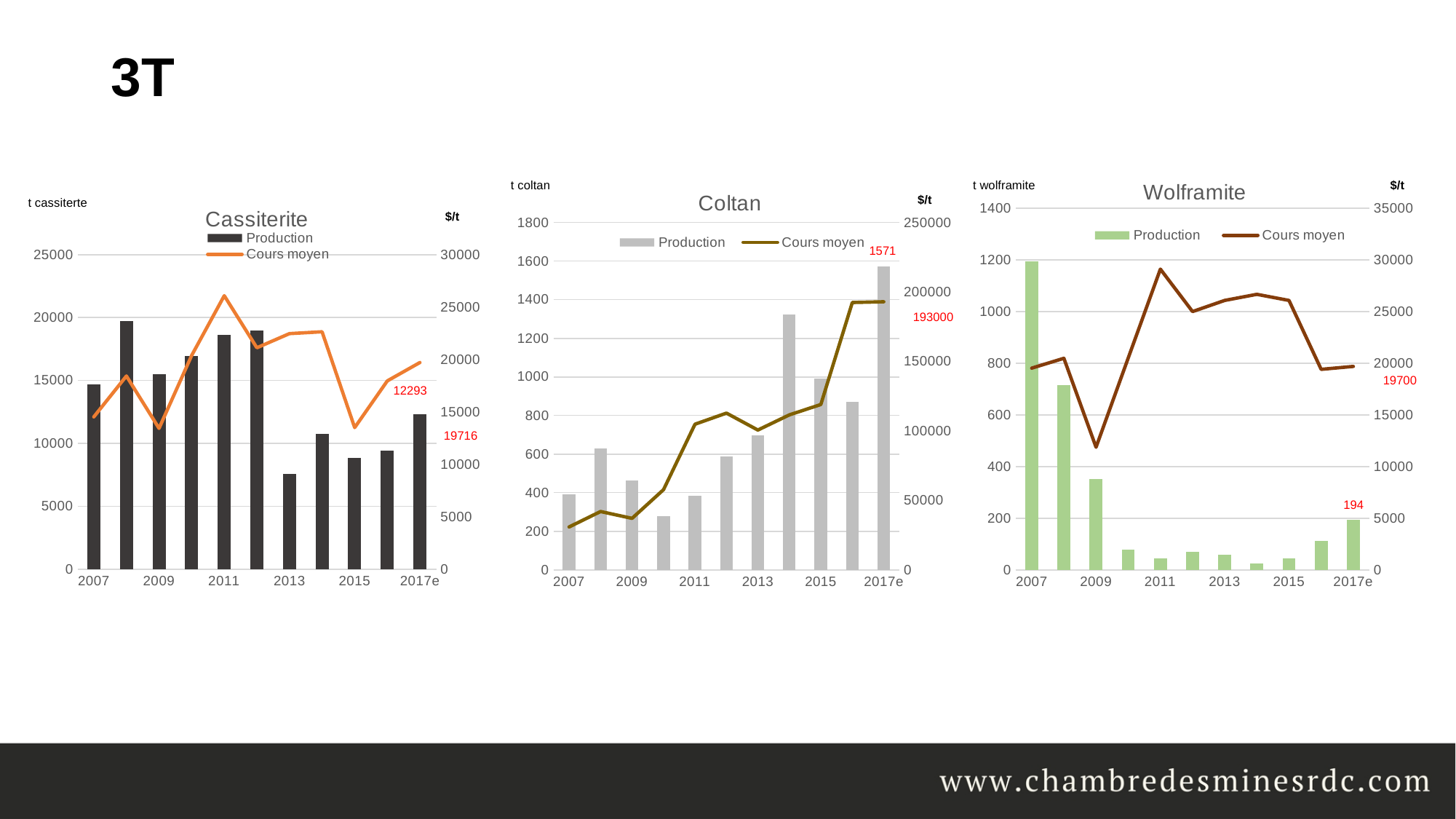
In the Coltan chart, what is the Cours moyen value labelled for 2017e? 193000 In the Wolframite chart, which year has the highest Production bar? 2007 In the Cassiterite chart, what is the Production value labelled for 2017e? 12293 In the Wolframite chart, what is the Cours moyen value labelled for 2017e? 19700 In the Coltan chart, what is the Production value labelled for 2017e? 1571 In the Coltan chart, which year has the highest Production bar? 2017e In the Cassiterite chart, which year has the lowest Production bar? 2013 In the Wolframite chart, what is the Production value labelled for 2017e? 194 How many series does the legend of the Wolframite chart list? 2 In the Cassiterite chart, what is the Cours moyen value labelled for 2017e? 19716 In the Cassiterite chart, is the Production value for 2008 greater or less than 15000? greater